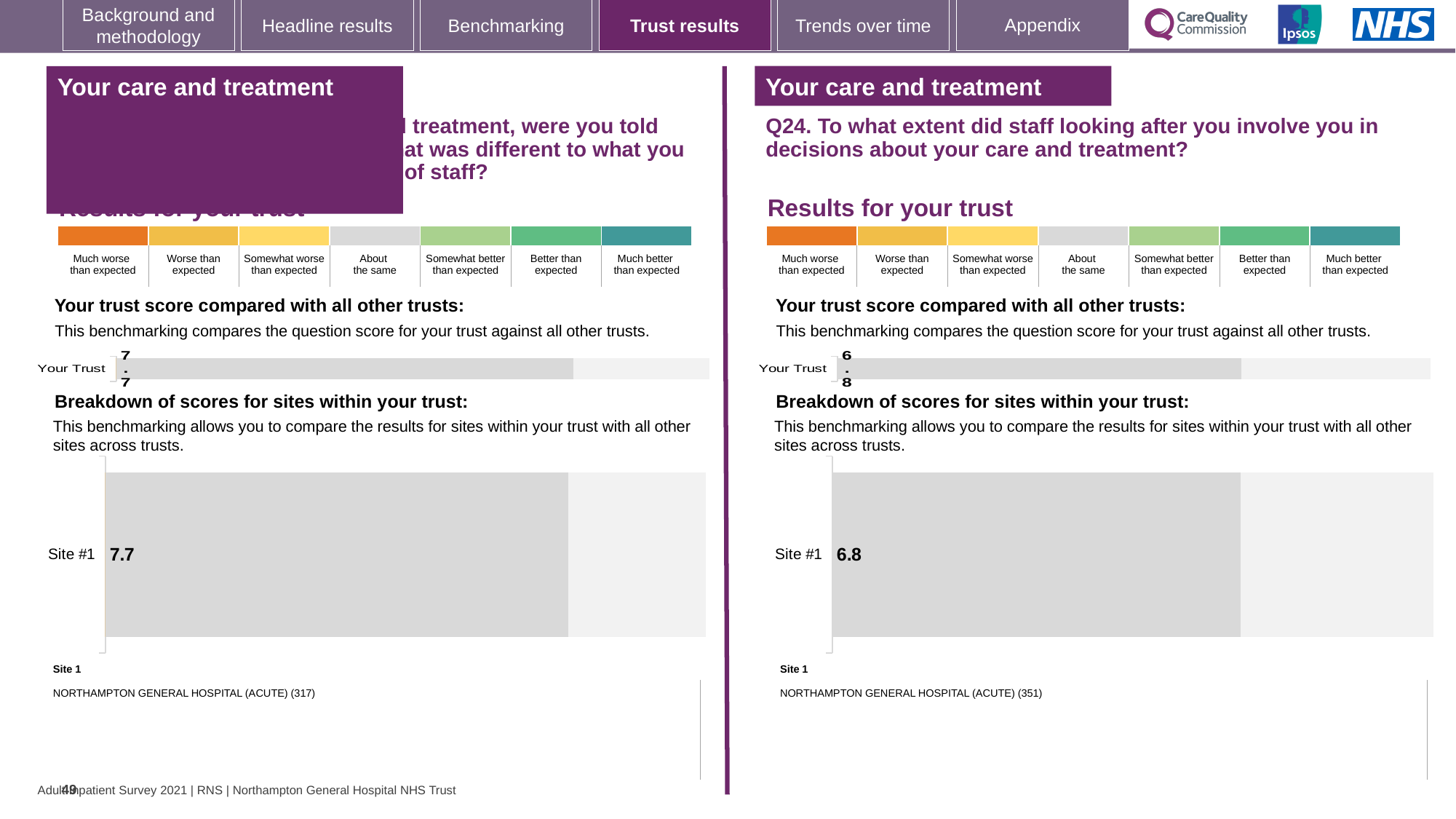
On the right half of the slide (Q24), what score is shown for Site #1 in the 'Breakdown of scores for sites within your trust' chart? 6.8 On the right half of the slide (Q24), which site is listed as Site 1 below the chart? NORTHAMPTON GENERAL HOSPITAL (ACUTE) (351) On the left half of the slide, which site is listed as Site 1 below the chart? NORTHAMPTON GENERAL HOSPITAL (ACUTE) (317) On the left half of the slide, what is the score shown for Your Trust in the 'Your trust score compared with all other trusts' chart? 7.7 How many sites are shown in the 'Breakdown of scores for sites within your trust' chart on the right half of the slide (Q24)? 1 Which is larger: the Your Trust score on the left half of the slide or the Your Trust score on the right half (Q24)? Left half (7.7) On the right half of the slide (Q24), what is the score shown for Your Trust in the 'Your trust score compared with all other trusts' chart? 6.8 What type of chart is used to show the Site #1 score on the left half of the slide? Bar chart On the right half of the slide (Q24), is the Your Trust score the same as the Site #1 score? Yes On the left half of the slide, what score is shown for Site #1 in the 'Breakdown of scores for sites within your trust' chart? 7.7 What is the difference between the Site #1 score on the left half of the slide and the Site #1 score on the right half (Q24)? 0.9